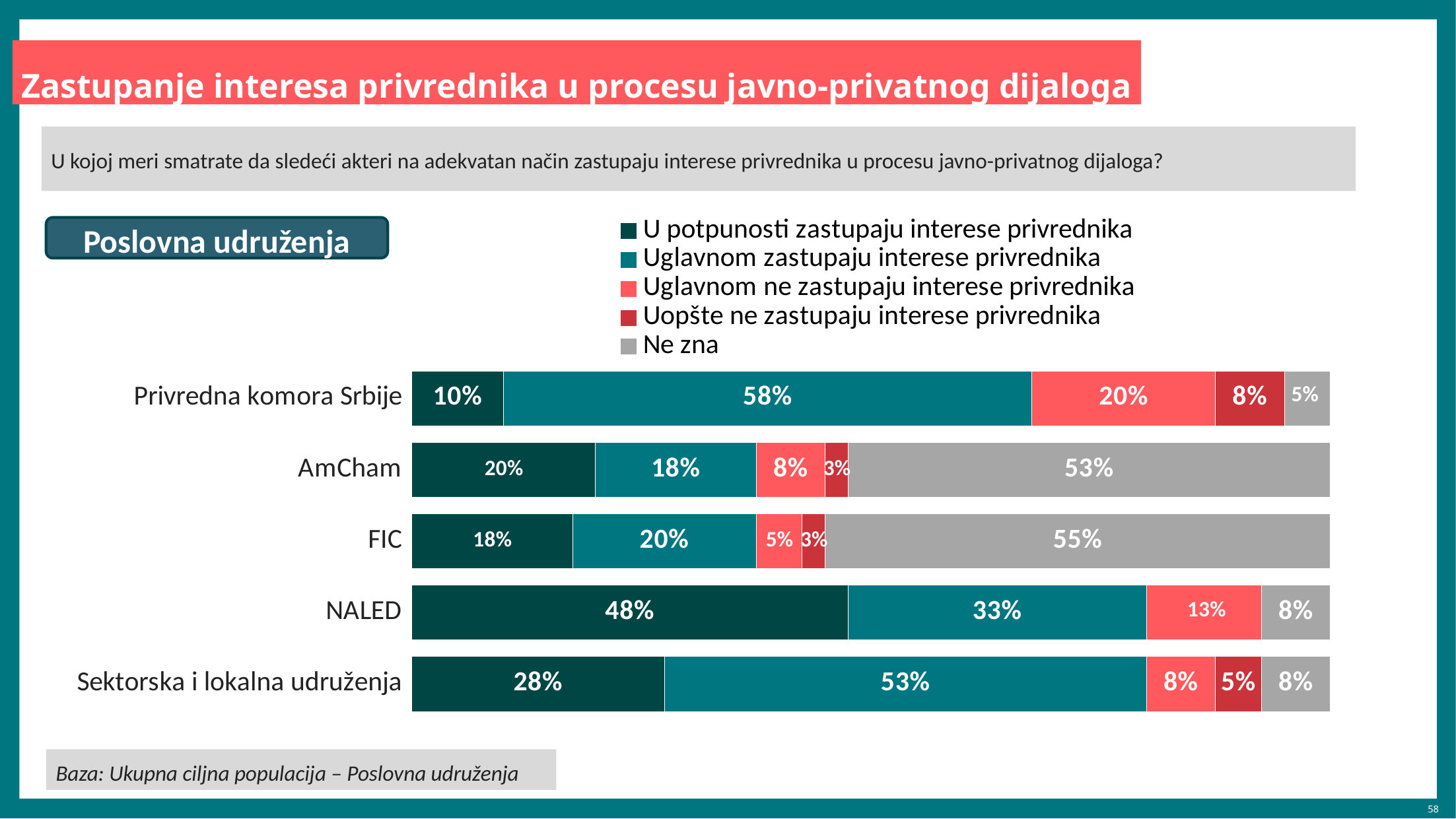
What percentage of respondents said NALED fully represents business interests (U potpunosti zastupaju interese privrednika)? 48% Which actor has the highest 'U potpunosti zastupaju interese privrednika' share? NALED What type of chart is shown on the slide? Stacked bar chart What is the difference between the 'Ne zna' values for FIC and AmCham? 2% What is the 'Uglavnom ne zastupaju interese privrednika' value for Sektorska i lokalna udruženja? 8% Which actor has the lowest 'U potpunosti zastupaju interese privrednika' share? Privredna komora Srbije What percentage said Privredna komora Srbije mostly represents business interests (Uglavnom zastupaju interese privrednika)? 58% How many series does the legend list? 5 Which has a larger 'Uglavnom zastupaju interese privrednika' share, NALED or Sektorska i lokalna udruženja? Sektorska i lokalna udruženja Which legend entry is shown in grey? Ne zna How many actors (categories) are shown in the chart? 5 What is the 'Ne zna' value for FIC? 55%